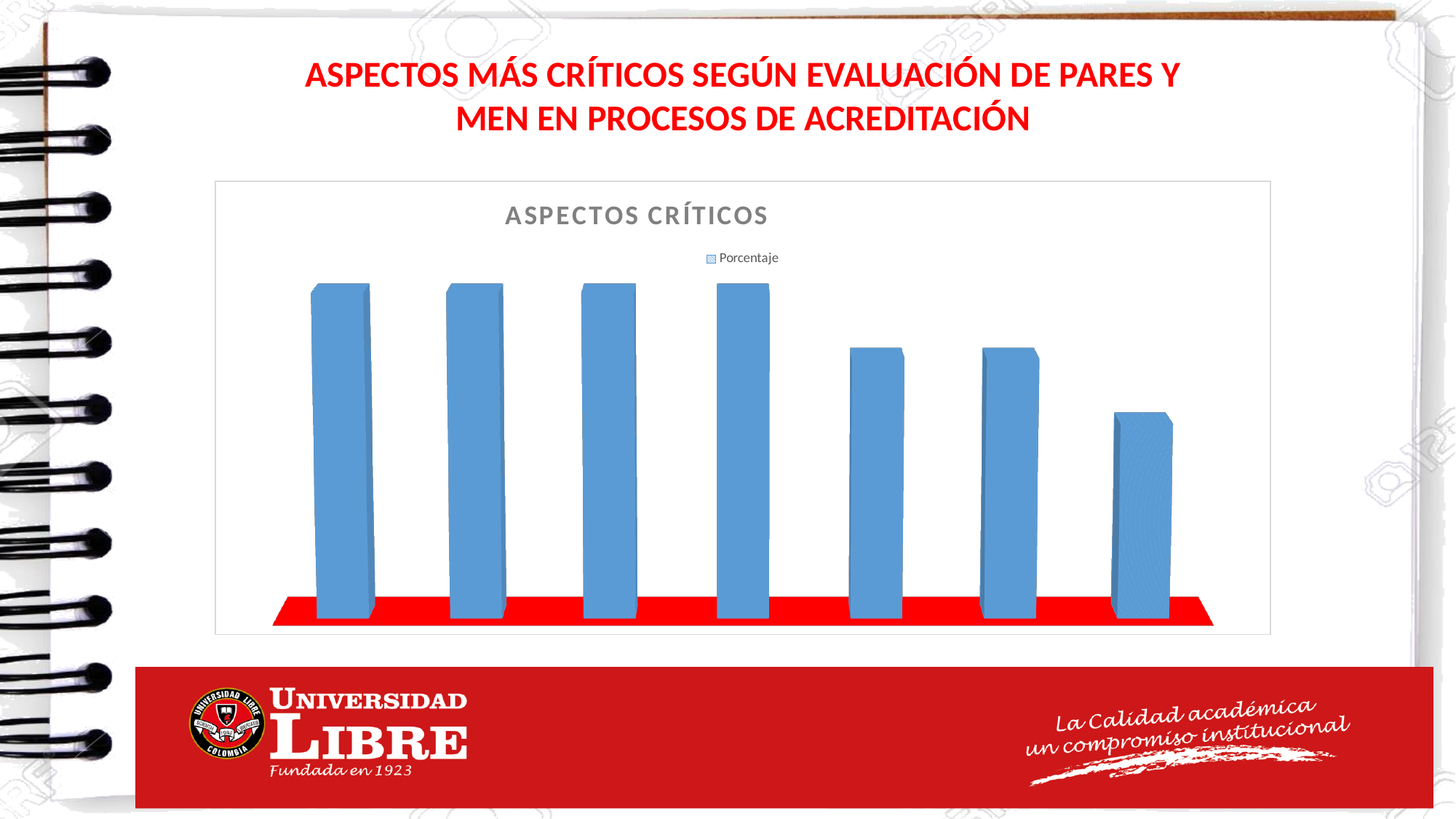
What series name appears in the chart legend? Porcentaje How many bars are plotted in the chart? 7 Which is larger, the fourth bar or the sixth bar? The fourth bar Do the bar values generally rise or fall from left to right across the chart? Fall Which is larger, the fifth bar or the seventh bar? The fifth bar What is the title of the chart? ASPECTOS CRÍTICOS Which bar is the lowest in the chart, by position? The rightmost (seventh) bar What kind of chart is shown on the slide? Bar chart How many series does the chart legend list? 1 Which is larger, the first (leftmost) bar or the last (rightmost) bar? The first (leftmost) bar